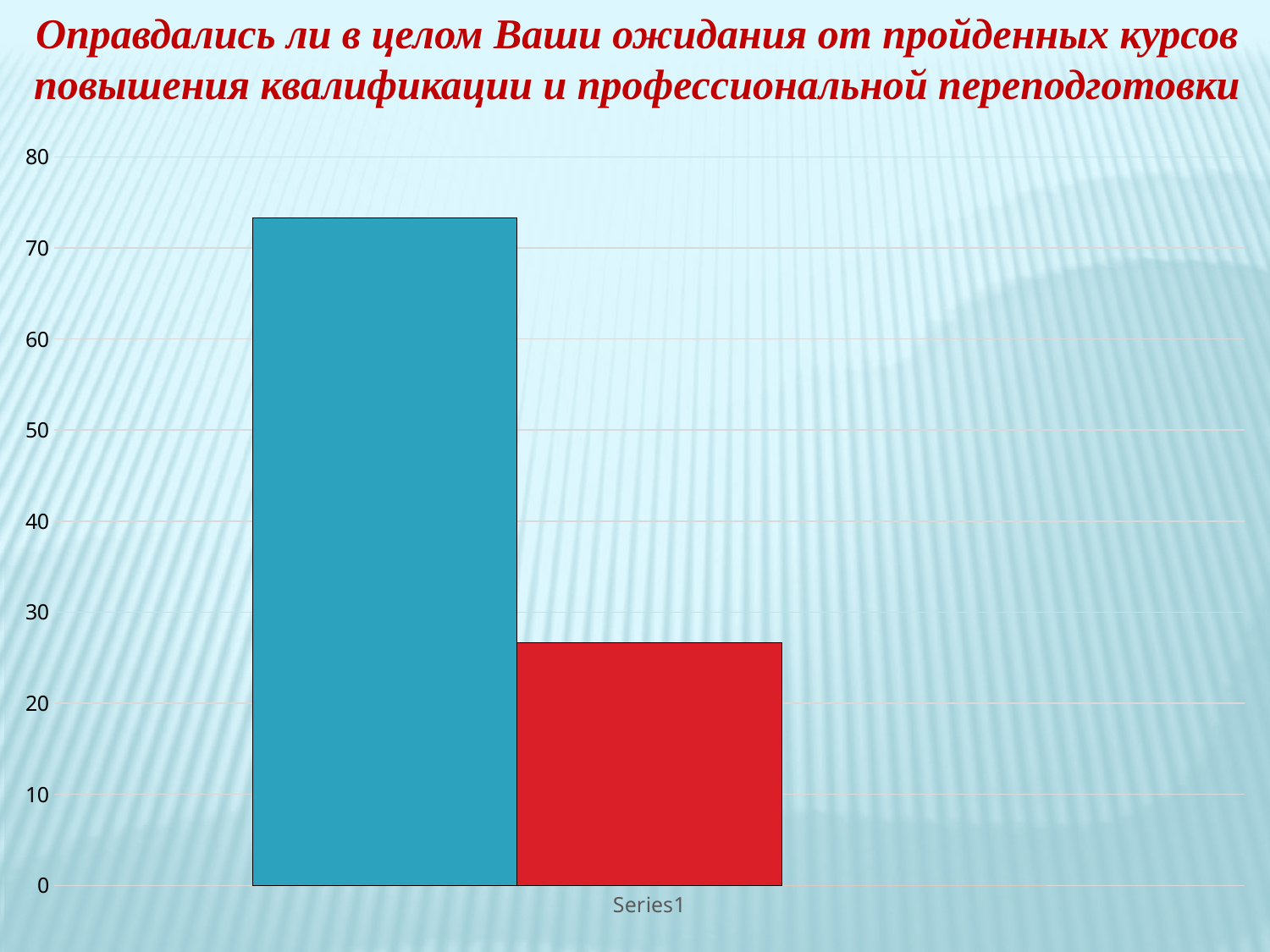
How many bars are plotted in the chart? 2 Which bar has the highest value in the chart? the blue bar Is the value of the blue bar greater or less than 80? less Which bar is taller, the blue bar or the red bar? the blue bar What label is shown on the horizontal axis under the bars? Series1 Is the value of the red bar greater or less than 20? greater What kind of chart is shown on the slide? bar chart Is the value of the red bar greater or less than 30? less What is the highest tick value shown on the vertical axis? 80 Which bar has the lowest value in the chart? the red bar